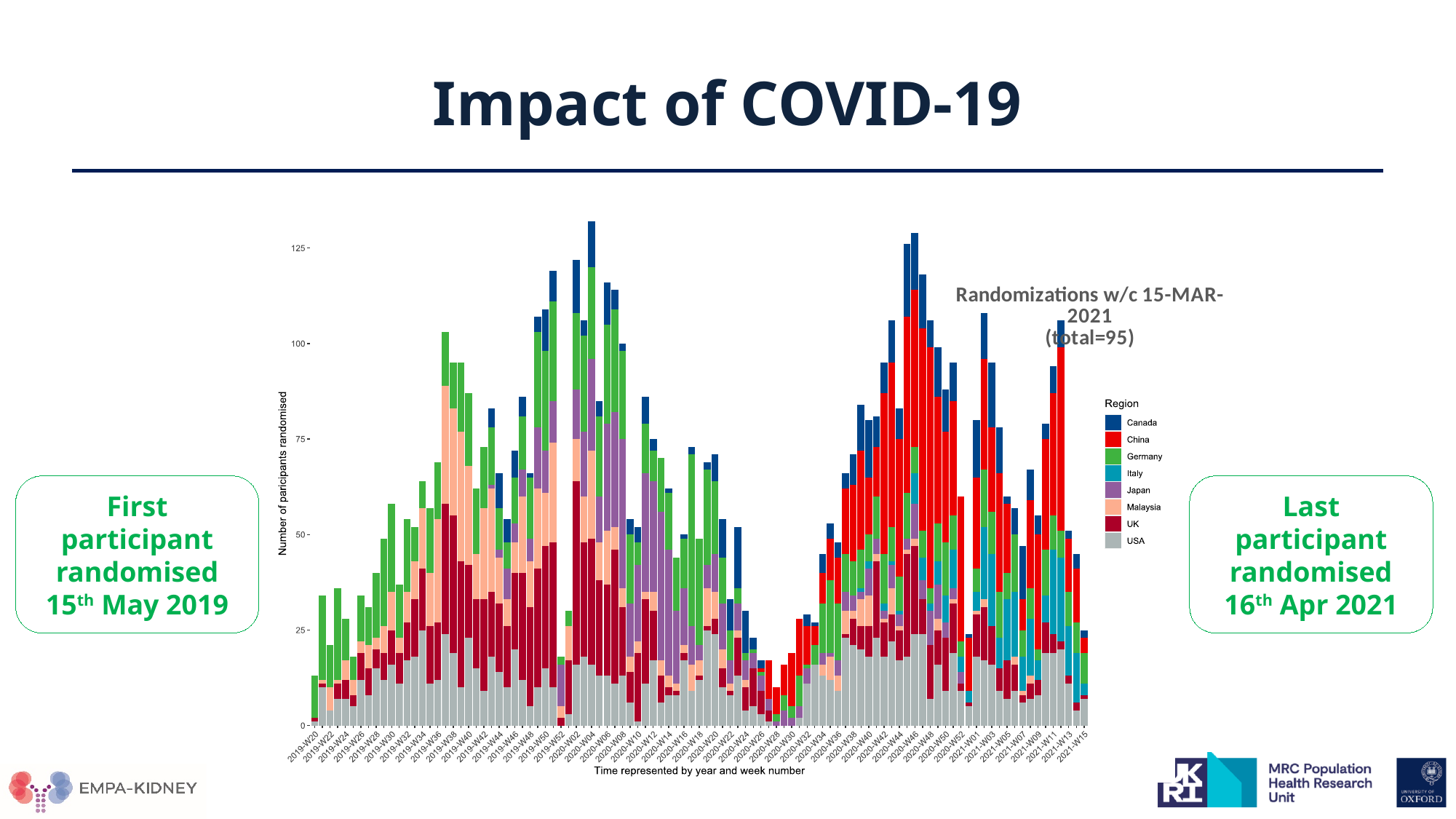
Which colour represents China in the chart legend? Red Is the number of participants randomised in 2021-W15 greater or less than 50? less Is the number of participants randomised in 2020-W46 greater or less than 100? greater Between 2020-W30 and 2020-W46, do the weekly numbers of participants randomised generally rise or fall? rise Is the number of participants randomised in 2020-W28 greater or less than 25? less According to the annotation on the chart, what was the total number of randomizations in the week commencing 15-MAR-2021? 95 What kind of chart is shown on the slide? Stacked bar chart How many regions does the chart legend list? 8 Between 2020-W08 and 2020-W28, do the weekly numbers of participants randomised generally rise or fall? fall What is the title of the chart's y axis? Number of paricipants randomised